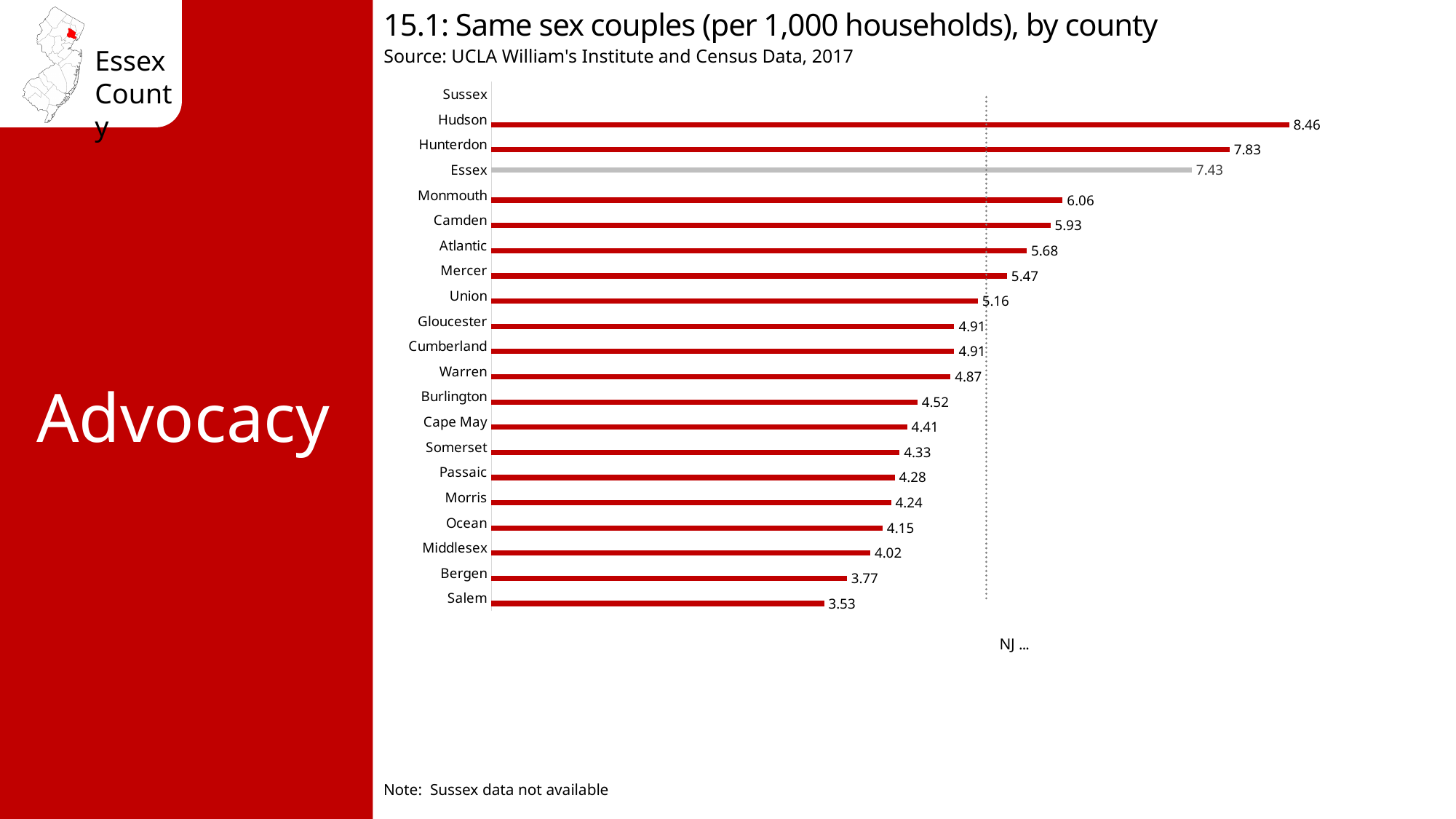
What is the difference between the values for Hunterdon and Essex? 0.40 What is the difference between the values for Hudson and Essex? 1.03 What is the value for Hudson in the chart? 8.46 Which county has the lowest plotted value in the chart? Salem What is the value for Bergen in the chart? 3.77 How many counties are listed on the category axis of the chart? 21 What kind of chart is shown on the slide? Bar chart Which county's bar is coloured grey instead of red? Essex Which county has the highest value in the chart? Hudson Which has a larger value, Union or Warren? Union Which has a larger value, Monmouth or Camden? Monmouth What is the value for Essex in the chart? 7.43